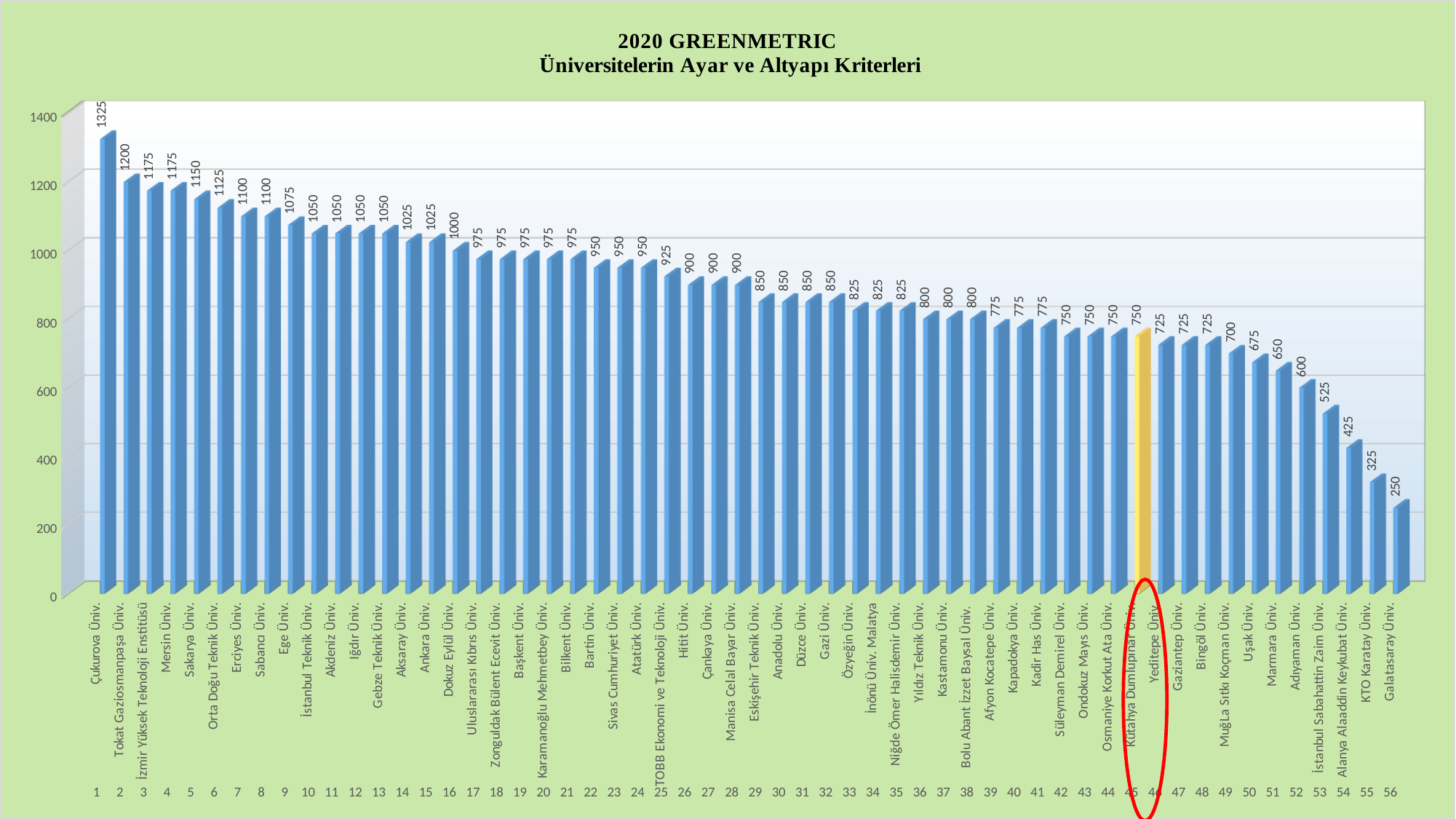
What is the value for Yeditepe Üniv.? 725 What is the value for Çukurova Üniv.? 1325 What is the value for Galatasaray Üniv.? 250 Is the value for KTO Karatay Üniv. greater or less than 400? less Which is larger, the value for Marmara Üniv. or the value for Adıyaman Üniv.? Marmara Üniv. Which university has the highest value? Çukurova Üniv. What kind of chart is shown on the slide? Bar chart What is the value for Orta Doğu Teknik Üniv.? 1125 What is the difference between the values for Çukurova Üniv. and Tokat Gaziosmanpaşa Üniv.? 125 How many universities are shown in the chart? 56 Which university's bar is highlighted in yellow and circled in red? Kütahya Dumlupınar Üniv. Which university has the lowest value? Galatasaray Üniv.